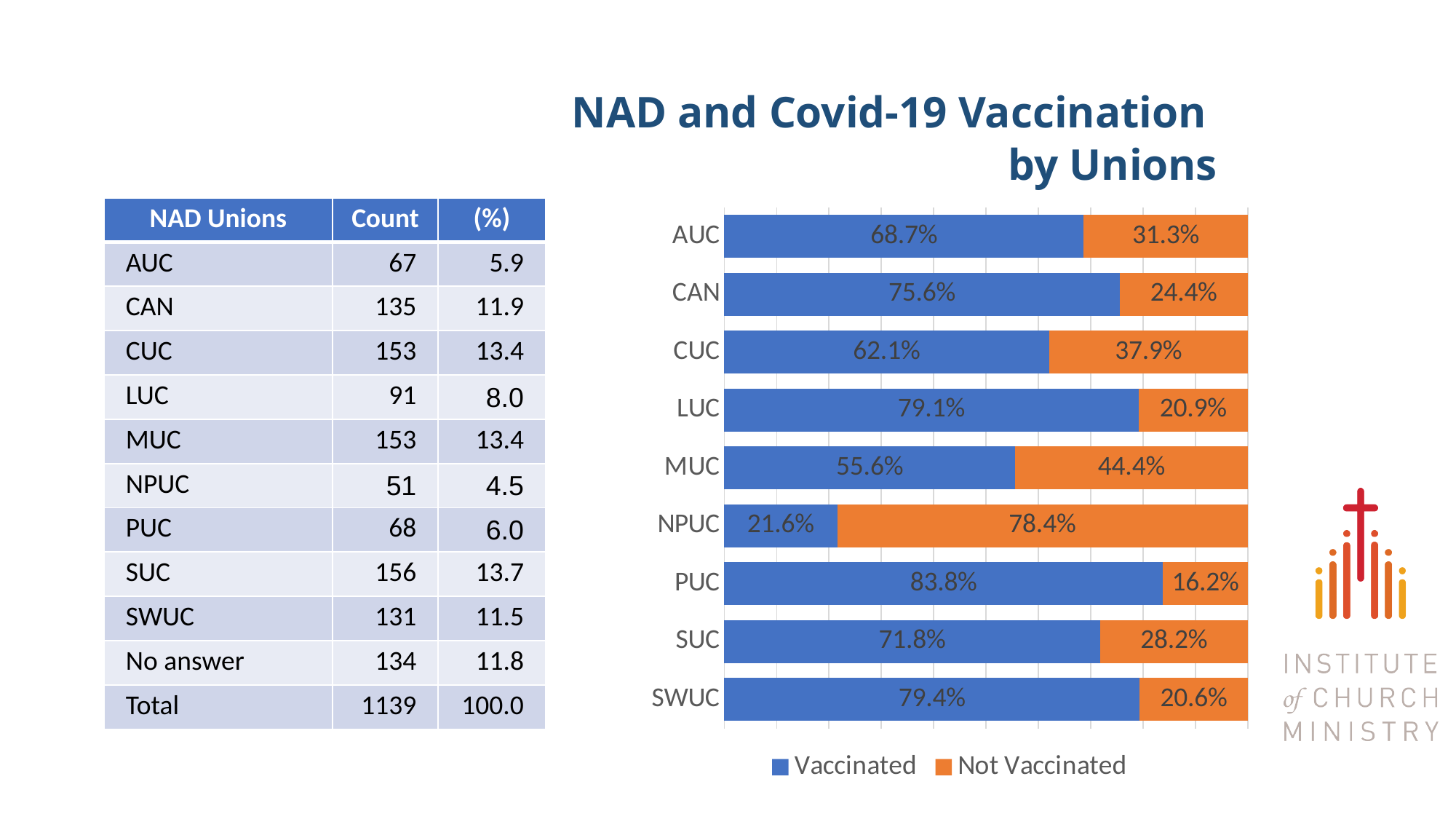
What is the Vaccinated percentage for NPUC? 21.6% What is the title of the chart? NAD and Covid-19 Vaccination by Unions What kind of chart is shown on the slide? Stacked bar chart What is the Vaccinated percentage for LUC? 79.1% What is the Not Vaccinated percentage for MUC? 44.4% Which has a larger Not Vaccinated percentage, AUC or SUC? AUC How many unions are shown in the chart? 9 How many series does the legend list? 2 What is the total of the stacked bar for CAN? 100% Which union has the highest Vaccinated percentage? PUC What is the difference between the Vaccinated percentages of PUC and CUC? 21.7% Which union has the lowest Vaccinated percentage? NPUC